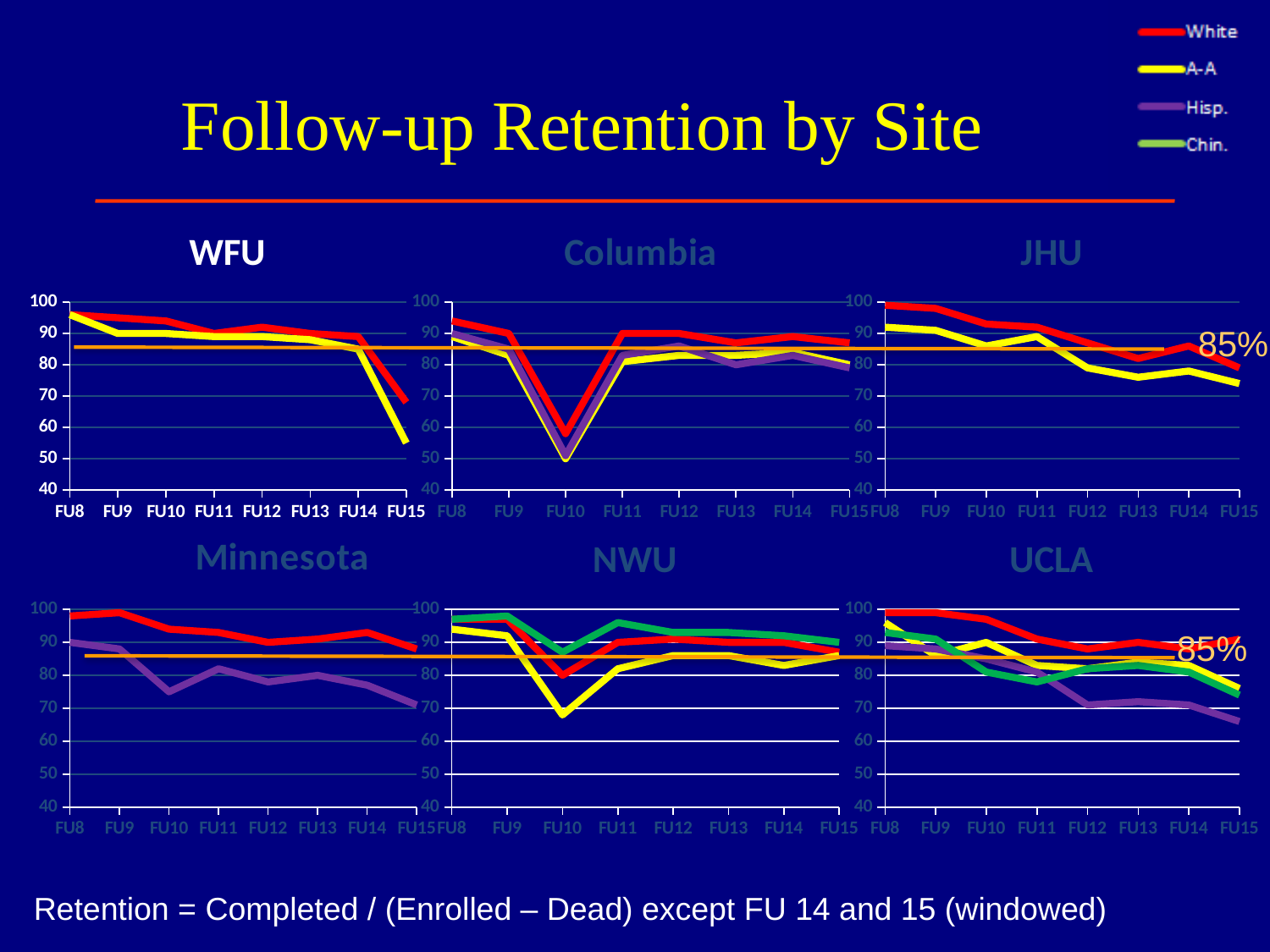
In the WFU chart, is the A-A value at FU15 greater or less than 60? less How many follow-up points are plotted along the x axis of the Columbia chart? 8 What kind of chart is used for the WFU panel? line chart In the UCLA chart, is the Hisp. value at FU15 greater or less than 70? less How many series does the legend at the top right of the slide list? 4 What value does the horizontal orange reference line in the JHU and UCLA charts mark? 85% In the Minnesota chart, which series is higher at FU10, White or Hisp.? White In the Columbia chart, at which follow-up does the A-A series reach its lowest value? FU10 In the Minnesota chart, is the Hisp. value at FU10 greater or less than 80? less In the JHU chart, does the A-A series rise or fall from FU8 to FU15? fall